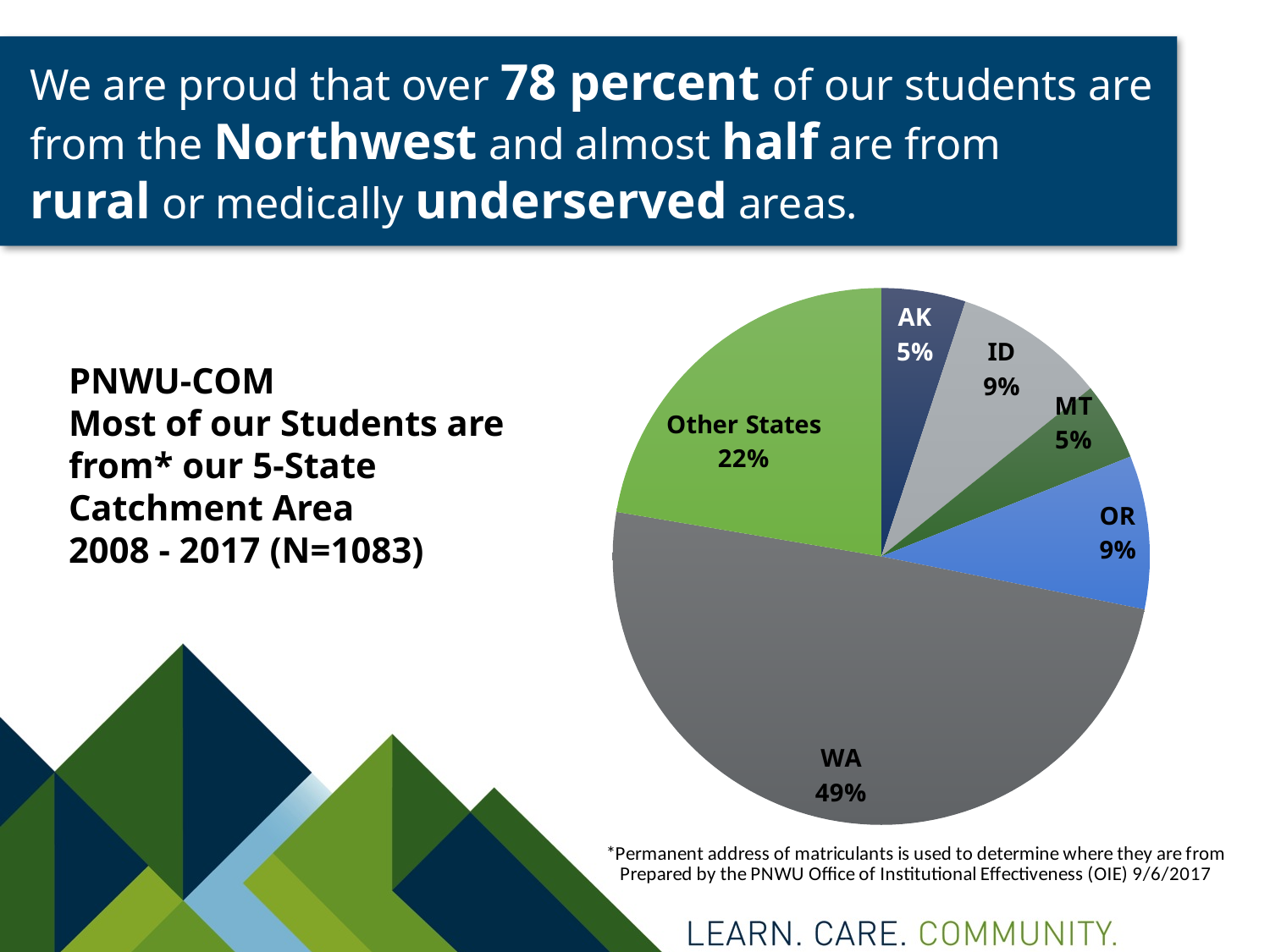
What is the difference between the ID share and the AK share? 4% What share of students is from WA? 49% Which slice of the pie is the largest? WA What type of chart is shown on the slide? pie chart What is the difference between the WA share and the Other States share? 27% What share of students is from ID? 9% Which is larger, the share for OR or the share for MT? OR What share of students is from Other States? 22% What is the N value stated in the chart's title text? 1083 What years does the chart cover according to its title text? 2008 - 2017 What share of students is from AK? 5% How many slices does the pie chart have? 6